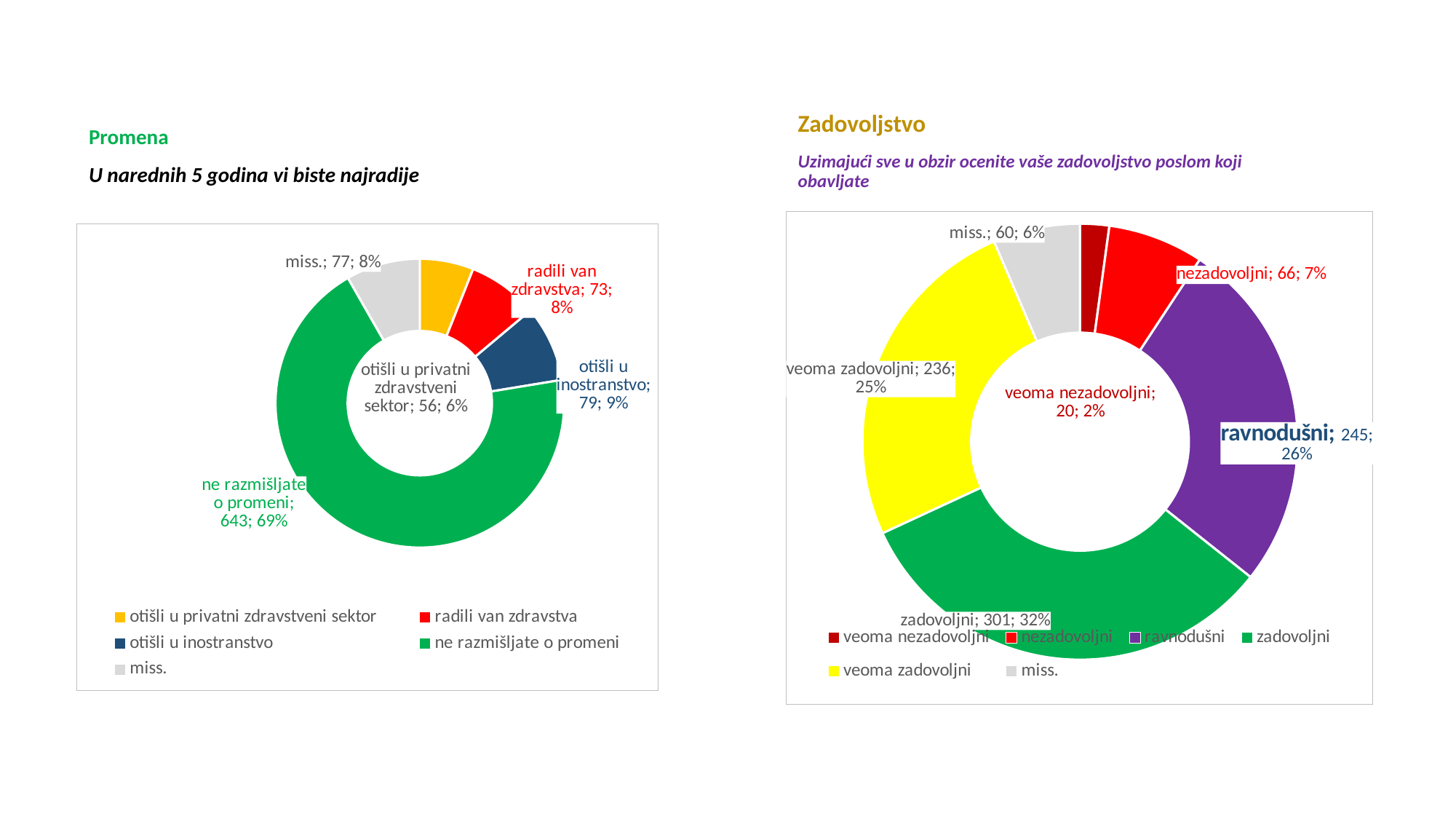
In the left chart (Promena), how many categories does the legend list? 5 What type of chart is the left chart (Promena)? doughnut chart In the left chart (Promena), which category has the smallest value? otišli u privatni zdravstveni sektor In the right chart (Zadovoljstvo), what is the count for 'ravnodušni'? 245 In the right chart (Zadovoljstvo), what colour is the 'ravnodušni' segment? purple In the right chart (Zadovoljstvo), which is larger: the value for 'nezadovoljni' or the value for 'miss.'? nezadovoljni In the right chart (Zadovoljstvo), what percentage share is shown for 'veoma zadovoljni'? 25% In the left chart (Promena), what is the difference between the counts for 'otišli u inostranstvo' and 'radili van zdravstva'? 6 In the right chart (Zadovoljstvo), which category has the smallest value? veoma nezadovoljni In the left chart (Promena), what is the count for 'ne razmišljate o promeni'? 643 In the right chart (Zadovoljstvo), which category has the largest value? zadovoljni In the left chart (Promena), what percentage share is shown for 'otišli u inostranstvo'? 9%